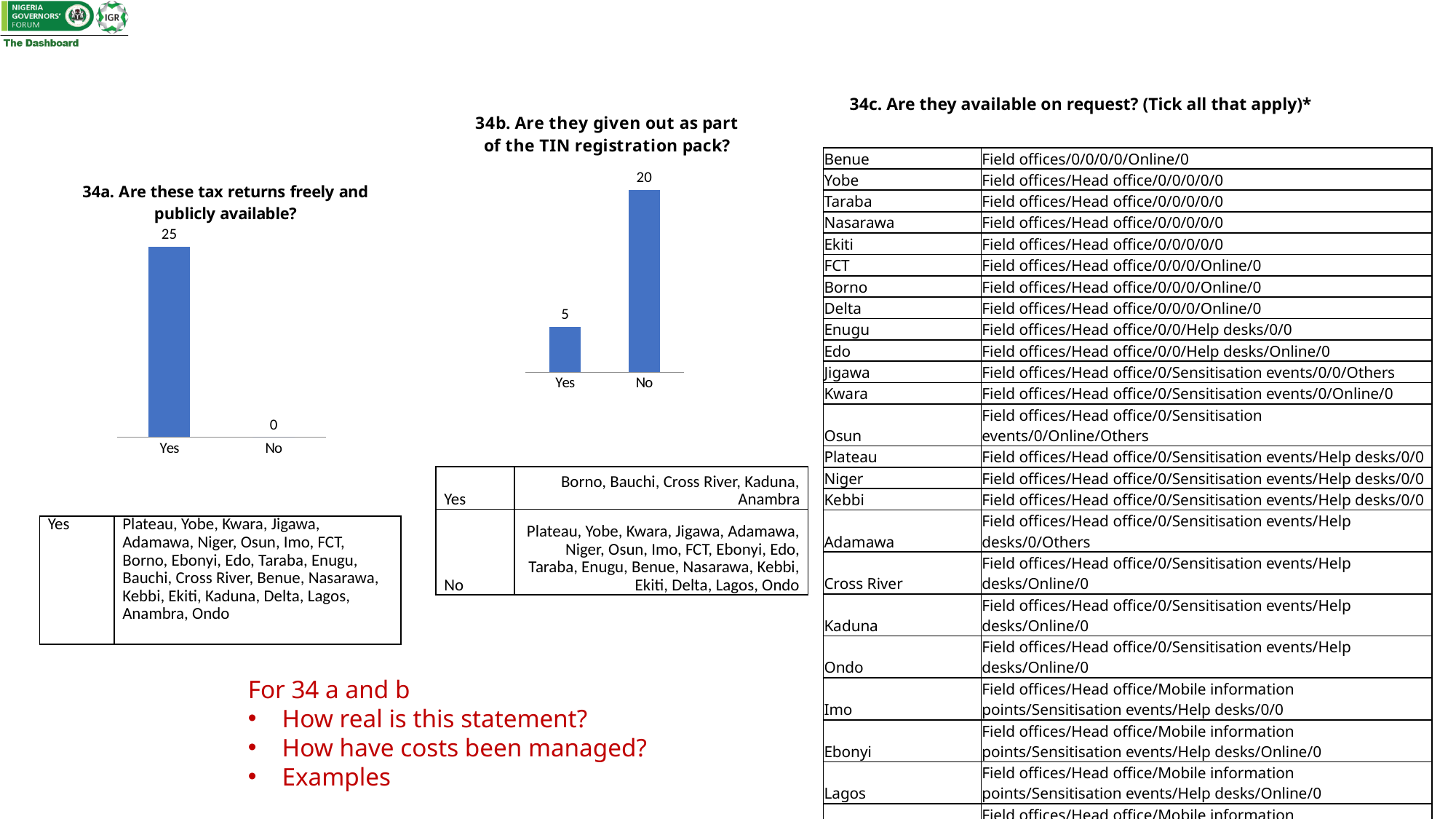
In the chart '34b. Are they given out as part of the TIN registration pack?', which is larger, Yes or No? No In the chart '34a. Are these tax returns freely and publicly available?', what is the value for Yes? 25 How many categories are shown in the chart '34a. Are these tax returns freely and publicly available?'? 2 What is the title of the chart on the left of the slide? 34a. Are these tax returns freely and publicly available? In the chart '34b. Are they given out as part of the TIN registration pack?', what is the value for No? 20 In the chart '34b. Are they given out as part of the TIN registration pack?', what is the value for Yes? 5 In the chart '34a. Are these tax returns freely and publicly available?', what is the difference between the Yes and No values? 25 In the chart '34b. Are they given out as part of the TIN registration pack?', which category has the lowest value? Yes In the chart '34b. Are they given out as part of the TIN registration pack?', what is the difference between the No and Yes values? 15 What kind of chart is '34b. Are they given out as part of the TIN registration pack?'? Bar chart In the chart '34a. Are these tax returns freely and publicly available?', what is the value for No? 0 In the chart '34a. Are these tax returns freely and publicly available?', which category has the highest value? Yes